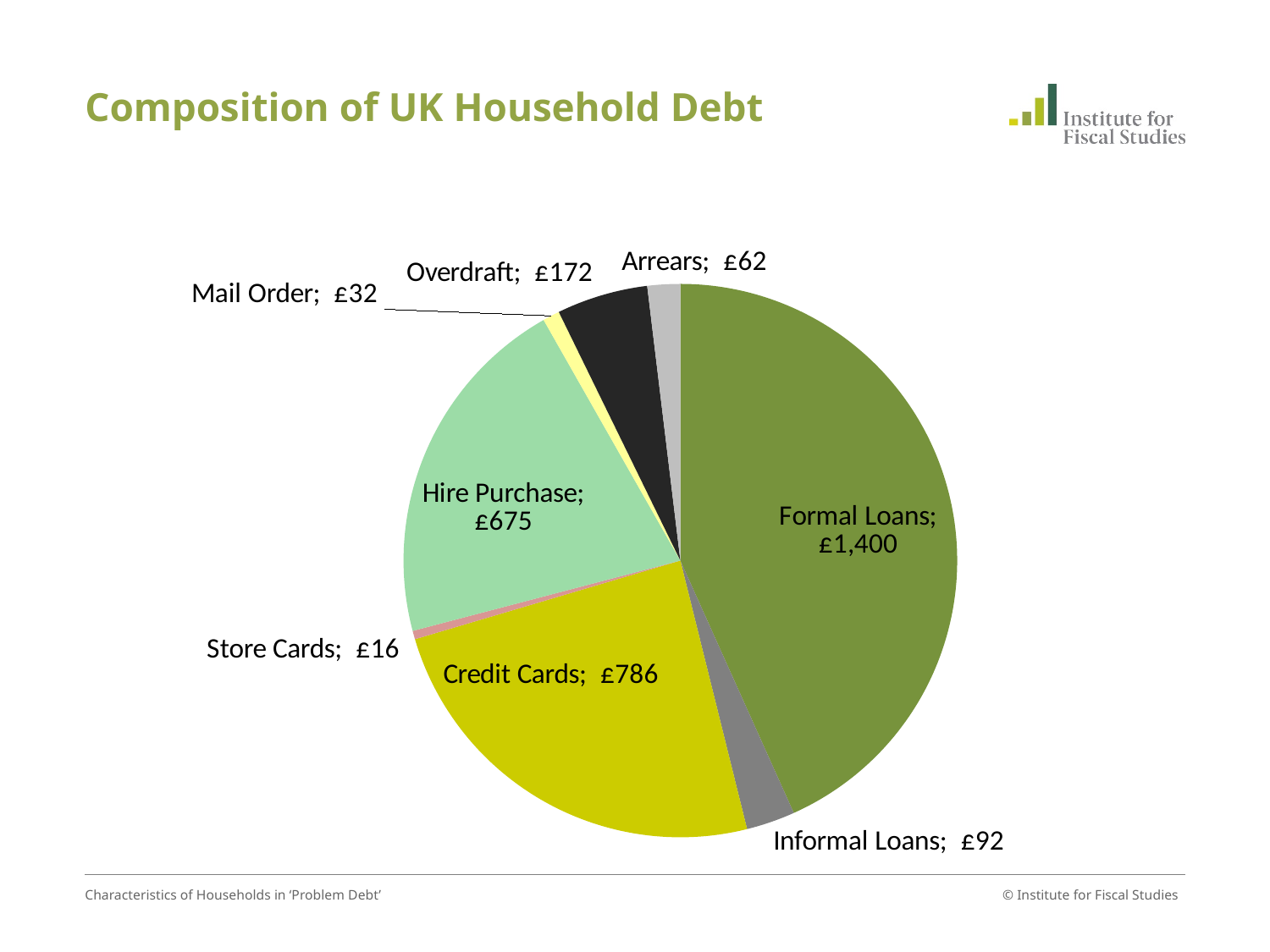
How many categories are shown in the pie chart? 8 What is the value for Overdraft? £172 What is the value for Hire Purchase? £675 What is the title of the chart? Composition of UK Household Debt What is the difference between Credit Cards and Hire Purchase? £111 Which is larger, Informal Loans or Arrears? Informal Loans What is the value for Formal Loans? £1,400 What type of chart is shown on the slide? Pie chart Which category has the smallest value? Store Cards Which category has the largest value? Formal Loans What is the difference between Overdraft and Mail Order? £140 What is the value for Store Cards? £16